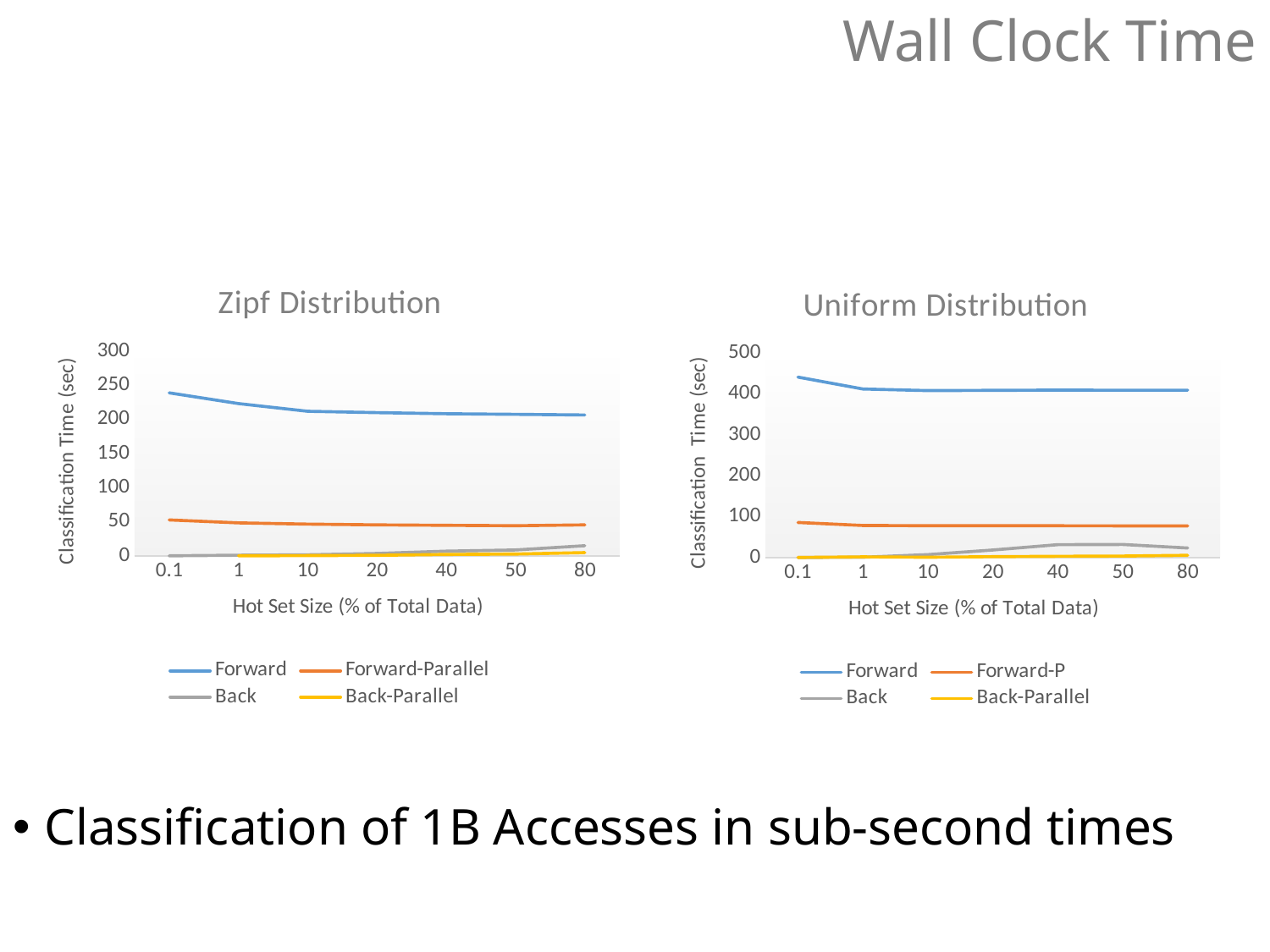
How many series does the legend of the Uniform Distribution chart list? 4 In the Uniform Distribution chart, is the Forward-P value at a hot set size of 80 greater or less than 100? less In the Uniform Distribution chart, is the Forward value at a hot set size of 0.1 greater or less than 400? greater How many hot set size values are plotted along the x axis of the Zipf Distribution chart? 7 In the Zipf Distribution chart, which is larger at a hot set size of 10: Forward or Forward-Parallel? Forward In the Zipf Distribution chart, does the Forward series rise or fall as hot set size increases from 0.1 to 80? fall In the Uniform Distribution chart, which series has the highest classification time across all hot set sizes? Forward What kind of chart is the Zipf Distribution chart? line chart What is the title of the chart on the left of the slide? Zipf Distribution In the Zipf Distribution chart, is the Forward-Parallel value at a hot set size of 0.1 greater or less than 100? less What is the x-axis label of the Uniform Distribution chart? Hot Set Size (% of Total Data)